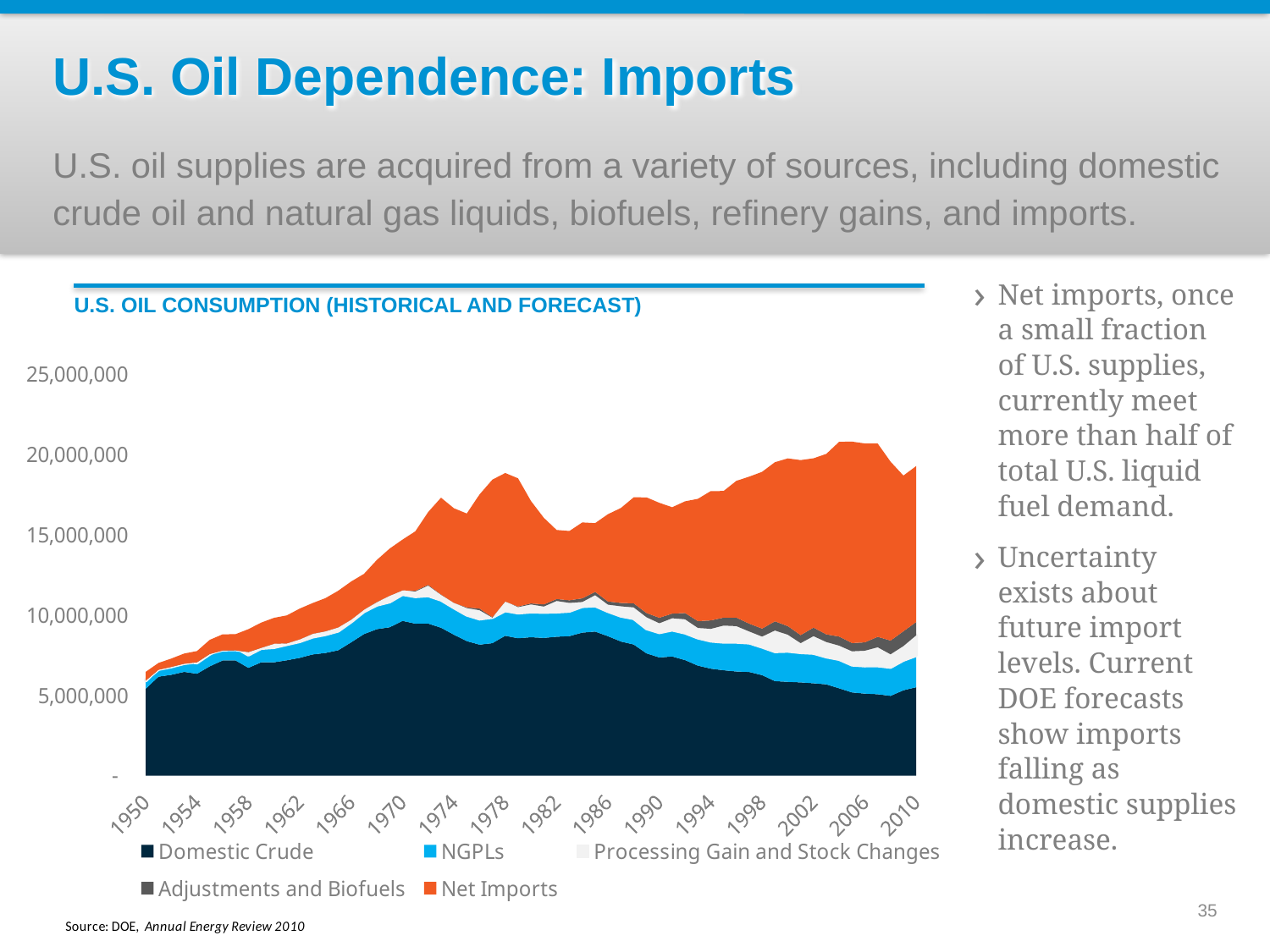
What is the first year shown on the x axis? 1950 What kind of chart is shown on the slide? Stacked area chart What is the title of the chart? U.S. OIL CONSUMPTION (HISTORICAL AND FORECAST) Which colour represents Net Imports in the chart? Orange Does the Net Imports area rise or fall between 1950 and 2006? Rise Does the Domestic Crude area rise or fall between 1970 and 2010? Fall Is the Domestic Crude value in 2010 greater or less than 10,000,000? less How many series does the chart's legend list? 5 How many year labels are shown on the x axis? 16 Is the total U.S. oil consumption in 1978 greater or less than 15,000,000? greater Is the total U.S. oil consumption in 1950 greater or less than 10,000,000? less